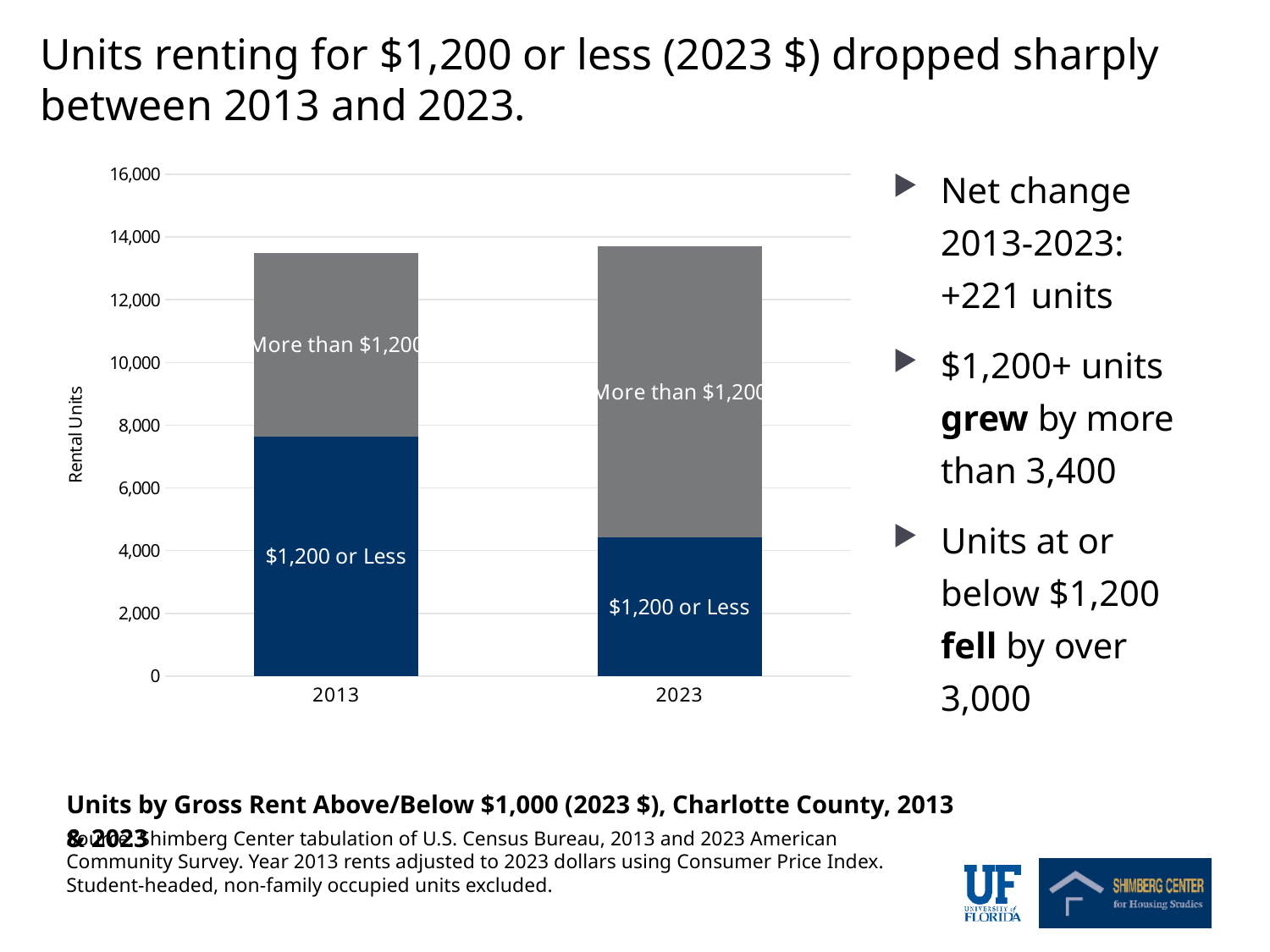
What is the label on the vertical axis of the chart? Rental Units Which year has the larger number of "More than $1,200" units, 2013 or 2023? 2023 Which year has the larger number of "$1,200 or Less" units, 2013 or 2023? 2013 What kind of chart is shown on the slide? Stacked bar chart Is the value for "$1,200 or Less" units in 2013 greater or less than 6,000? greater Is the total height of the 2023 bar greater or less than 12,000? greater Is the total height of the 2013 bar greater or less than 12,000? greater How many rent series are stacked in each bar of the chart? 2 How many years (categories) are shown on the x axis of the chart? 2 Does the number of "$1,200 or Less" units rise or fall from 2013 to 2023? fall Which series is shown in dark blue at the bottom of each stacked bar? $1,200 or Less